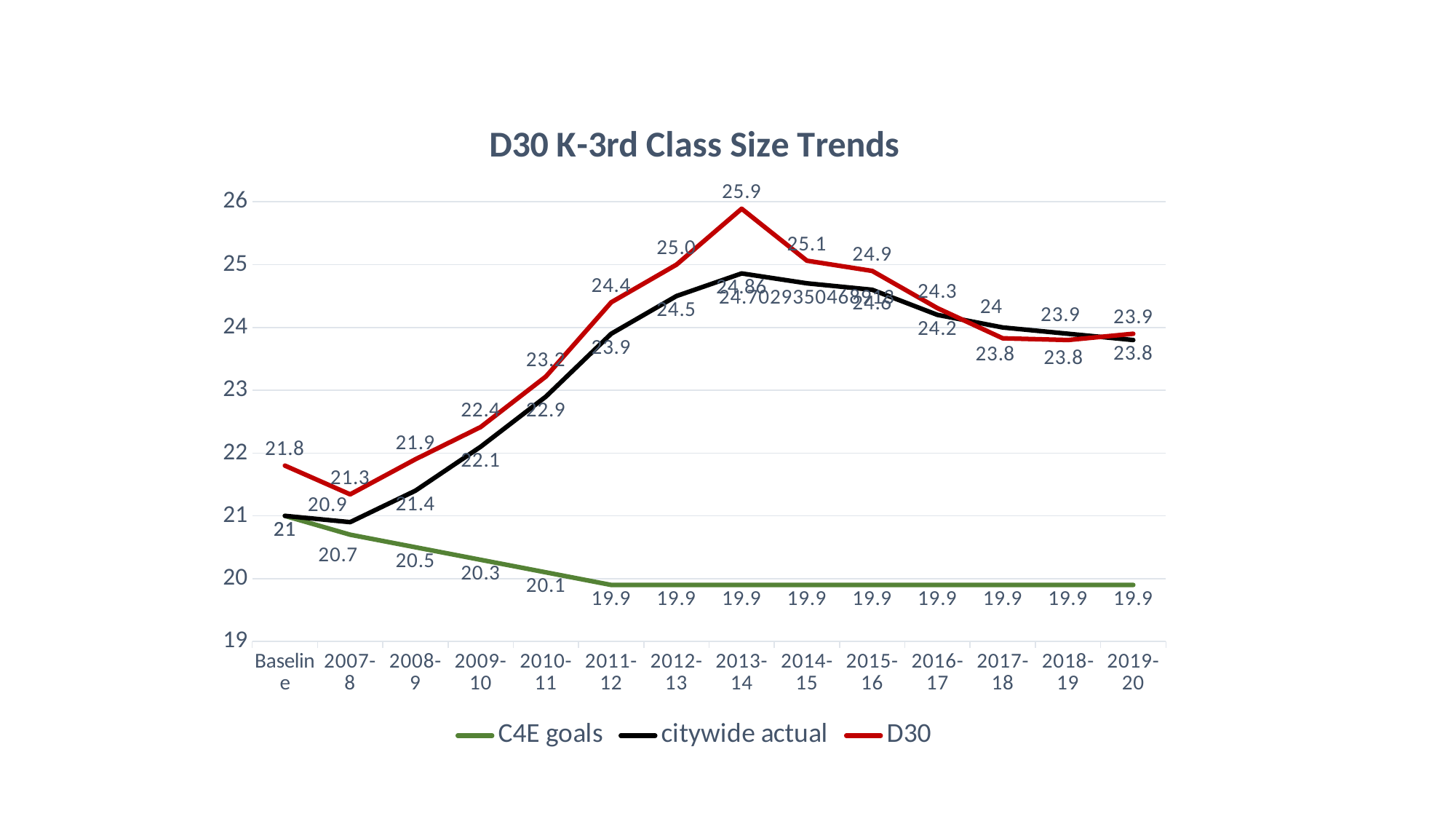
What is the title of the chart? D30 K-3rd Class Size Trends How many categories are shown on the x axis? 14 Does the C4E goals series rise or fall from Baseline to 2011-12? fall What is the citywide actual value for 2011-12? 23.9 What type of chart is shown on the slide? line chart What is the difference between the D30 value and the citywide actual value for 2012-13? 0.5 How many series does the legend list? 3 What is the lowest value of the D30 series? 21.3 In which year does the D30 series reach its highest value? 2013-14 What is the D30 value for 2013-14? 25.9 Which is larger for 2010-11, the D30 value or the citywide actual value? D30 What is the C4E goals value for 2009-10? 20.3